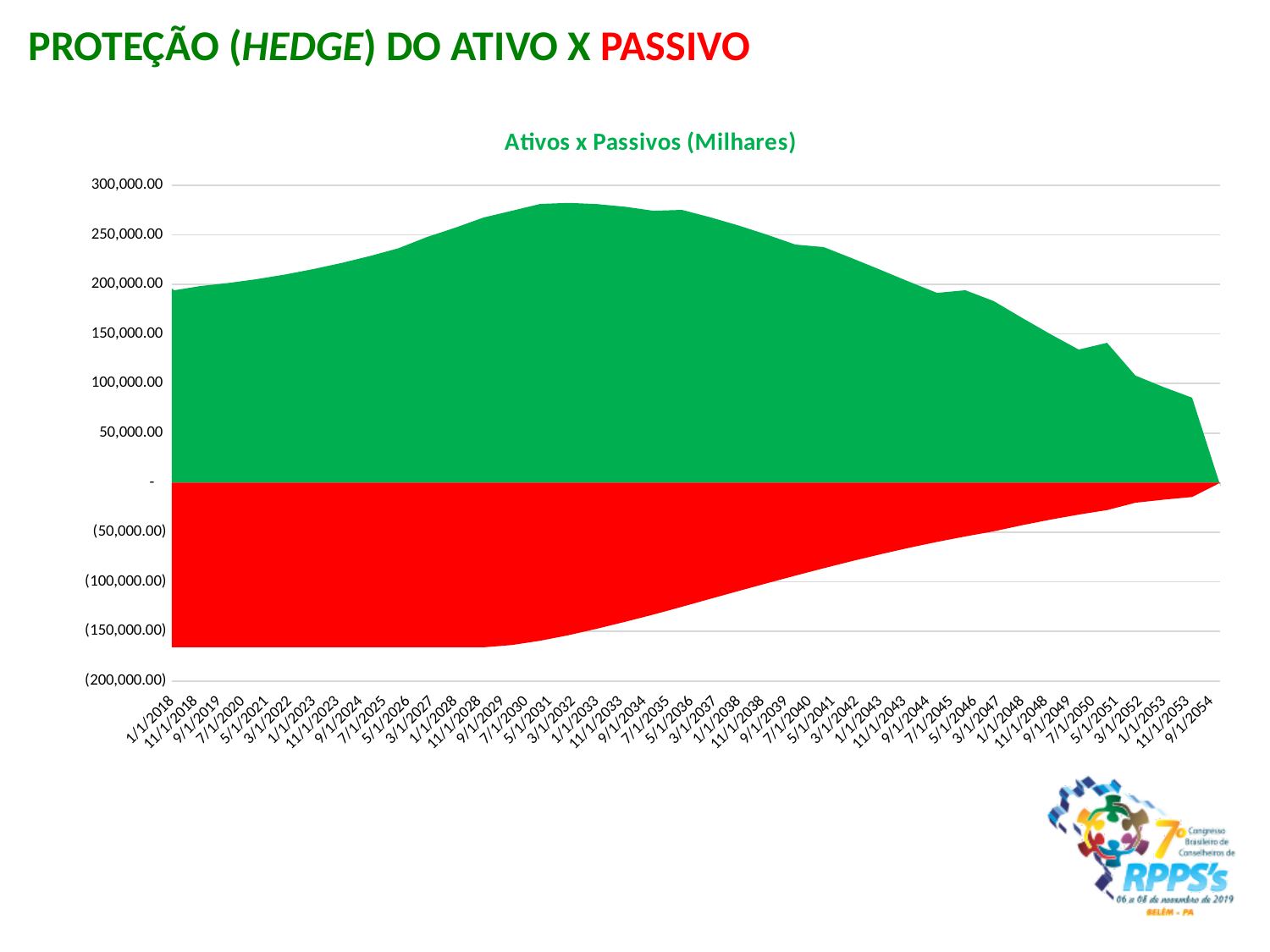
Is the red (Passivos) value at 9/1/2054 greater or less than (50,000.00)? greater What colour is the area plotted above the zero line? Green Is the green (Ativos) value at 7/1/2040 greater or less than 200,000.00? greater Does the green (Ativos) area rise or fall between 1/1/2018 and 5/1/2031? Rise Is the green (Ativos) value at 9/1/2054 greater or less than 50,000.00? less What is the title of the chart? Ativos x Passivos (Milhares) Does the green (Ativos) area rise or fall between 5/1/2031 and 9/1/2054? Fall What kind of chart is shown on the slide? Area chart What is the highest value shown on the vertical axis? 300,000.00